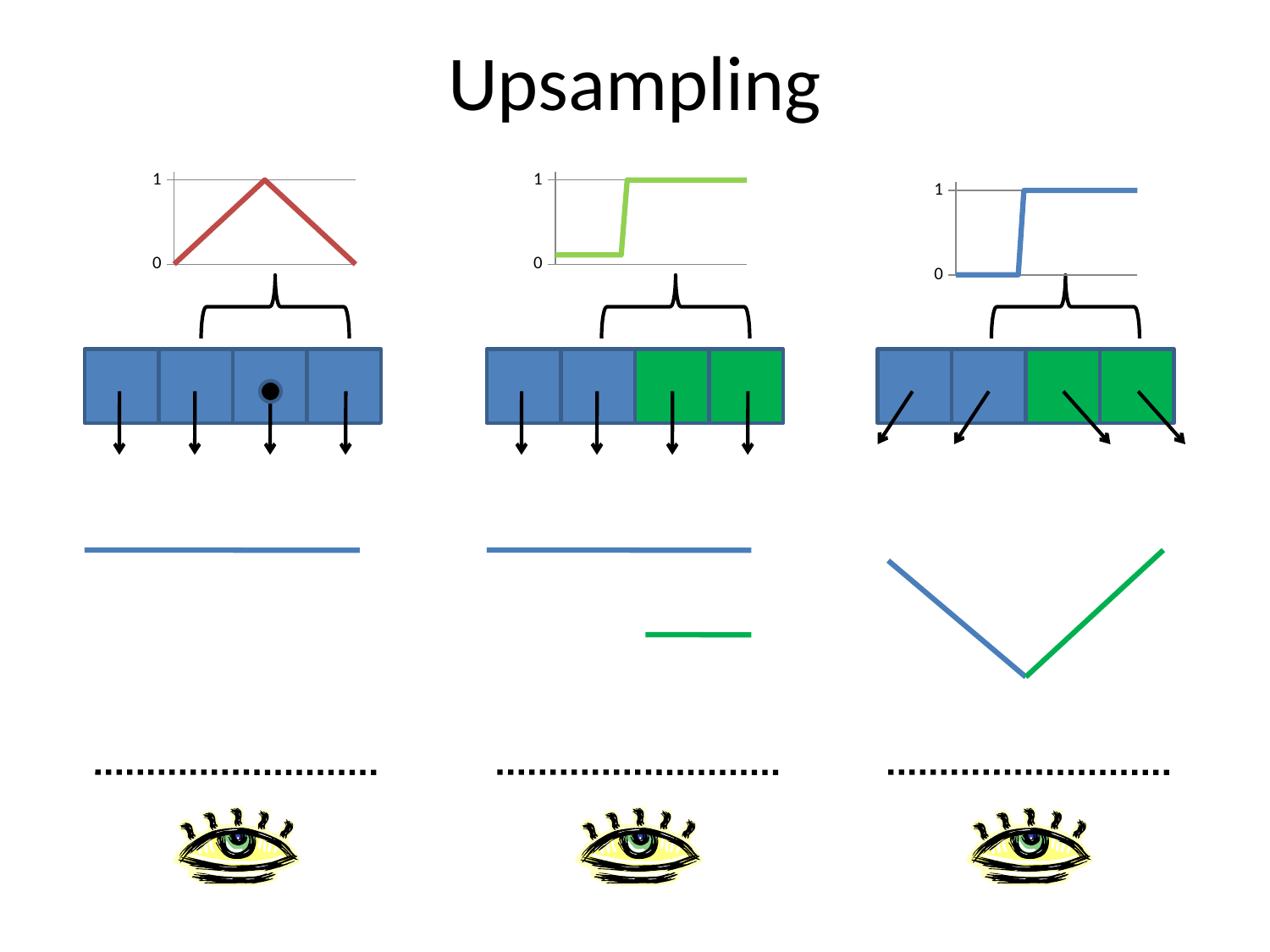
How many small charts are shown at the top of the slide? 3 What colour is the line in the left chart at the top of the slide? red In the right chart at the top of the slide, does the line rise or fall along the x axis? rise What kind of chart is the left chart at the top of the slide? line chart In the middle chart at the top of the slide, what value does the line reach on the right side? 1 In the left chart at the top of the slide, what is the lowest value the line reaches? 0 In the left chart at the top of the slide, what is the highest value the line reaches? 1 What colour is the line in the middle chart at the top of the slide? green In the right chart at the top of the slide, what value does the line end at on the right? 1 In the left chart at the top of the slide, does the line rise, fall, or rise then fall along the x axis? rise then fall In the right chart at the top of the slide, what value does the line start at on the left? 0 What are the two tick values shown on the y axis of the middle chart at the top of the slide? 0 and 1